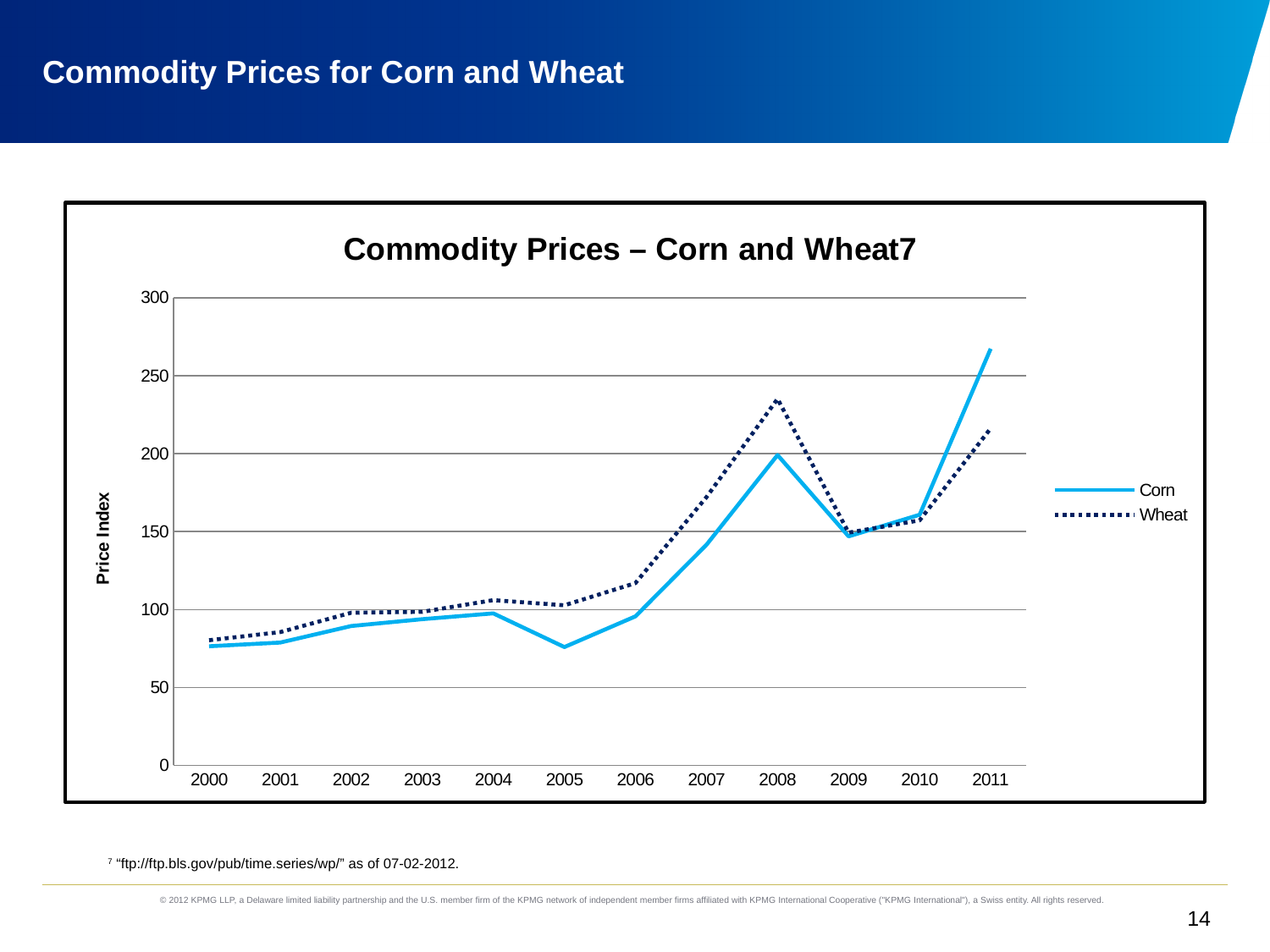
What is the label on the y axis? Price Index Is the value for Corn in 2005 greater or less than 100? less How many years are plotted along the x axis? 12 In 2011, which series has the higher value, Corn or Wheat? Corn Is the value for Corn in 2011 greater or less than 250? greater How many series does the legend list? 2 In 2008, which series has the higher value, Corn or Wheat? Wheat In which year does the Corn series reach its highest value? 2011 In which year does the Wheat series reach its highest value? 2008 Is the value for Wheat in 2008 greater or less than 200? greater What kind of chart is shown on the slide? line chart